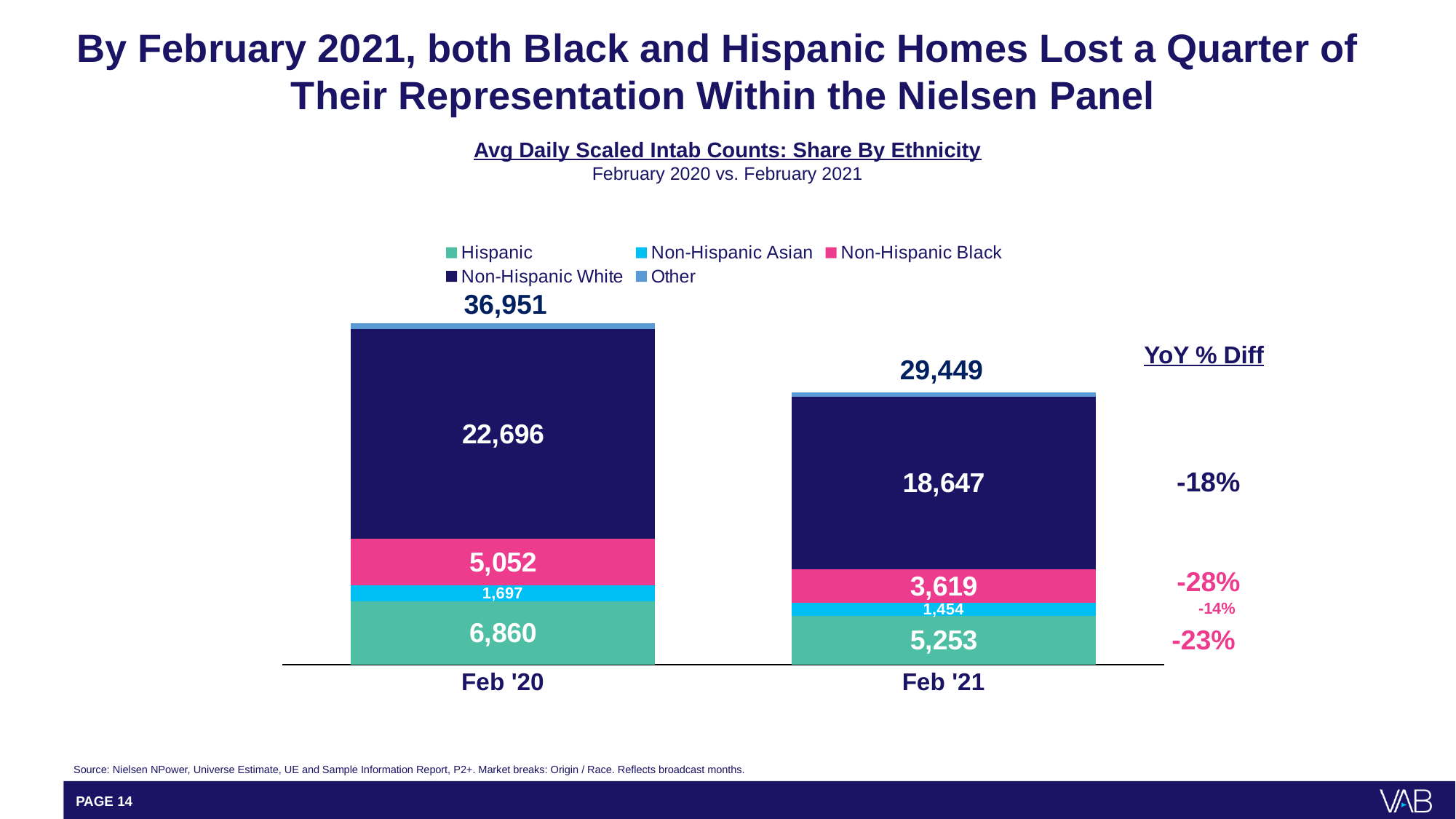
What is the difference between the Hispanic values for Feb '20 and Feb '21? 1,607 What is the Hispanic value for Feb '21? 5,253 What is the Non-Hispanic Asian value for Feb '20? 1,697 What is the total of the stacked bar for Feb '21? 29,449 Which segment is larger in Feb '20: Non-Hispanic Black or Hispanic? Hispanic How many bars (time periods) are plotted on the chart? 2 What is the Non-Hispanic White value for Feb '20? 22,696 How many series does the legend list? 5 What is the Non-Hispanic Black value for Feb '21? 3,619 What type of chart is shown on the slide? Stacked bar chart What YoY % Diff is shown for Non-Hispanic Black? -28% What is the difference between the Feb '20 and Feb '21 totals? 7,502